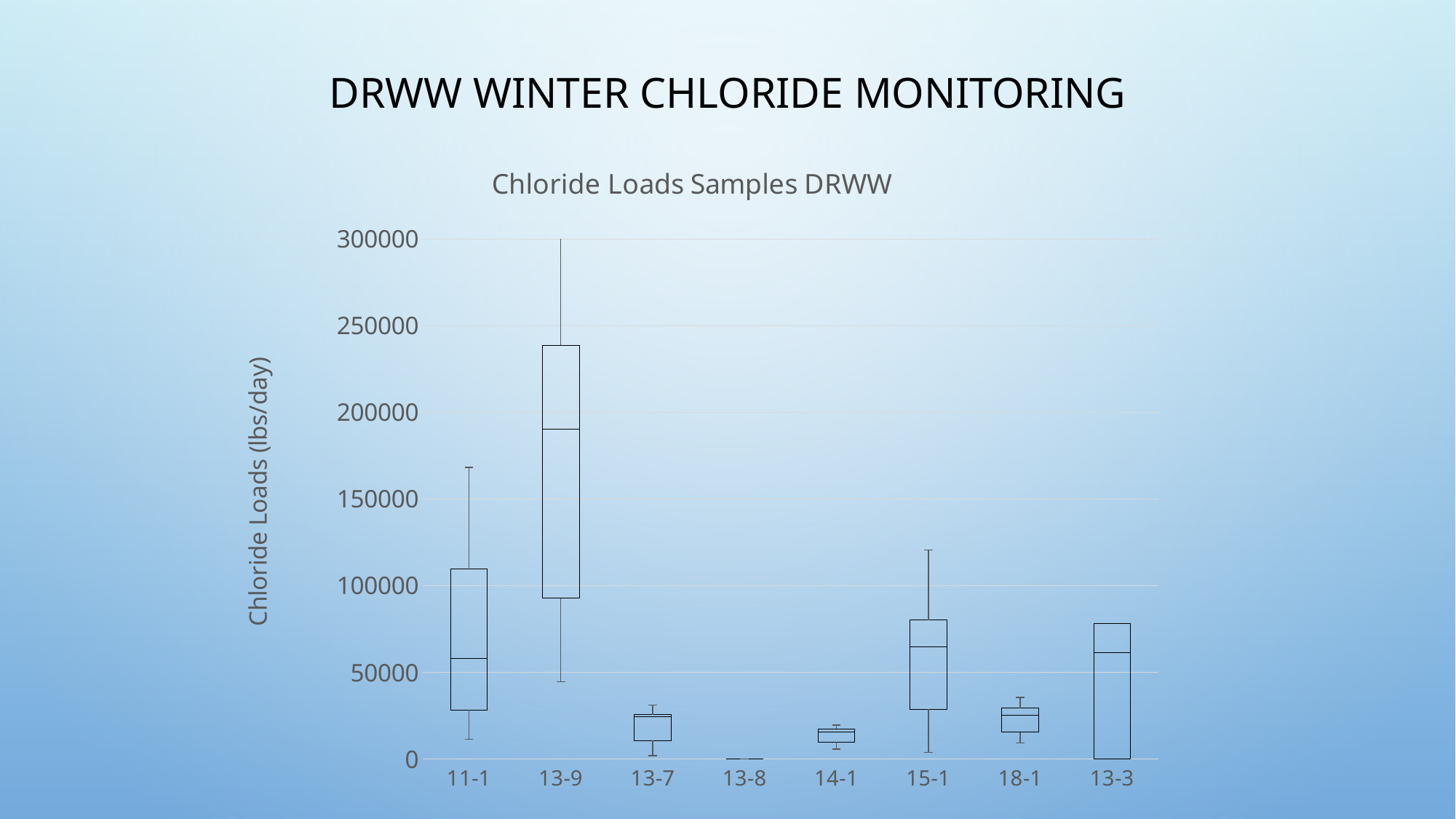
Which site has the larger median chloride load, 13-9 or 11-1? 13-9 How many sample sites are shown along the x axis? 8 What is the label on the vertical axis? Chloride Loads (lbs/day) Is the median chloride load for site 13-7 greater or less than 50000? less Which sample site has the highest median chloride load? 13-9 Is the top whisker for site 13-9 greater or less than 250000? greater Which site has the larger median chloride load, 14-1 or 15-1? 15-1 Is the median chloride load for site 13-9 greater or less than 150000? greater What kind of chart is shown on the slide? Box-and-whisker plot Which sample site has the lowest chloride loads? 13-8 What is the title of the chart? Chloride Loads Samples DRWW